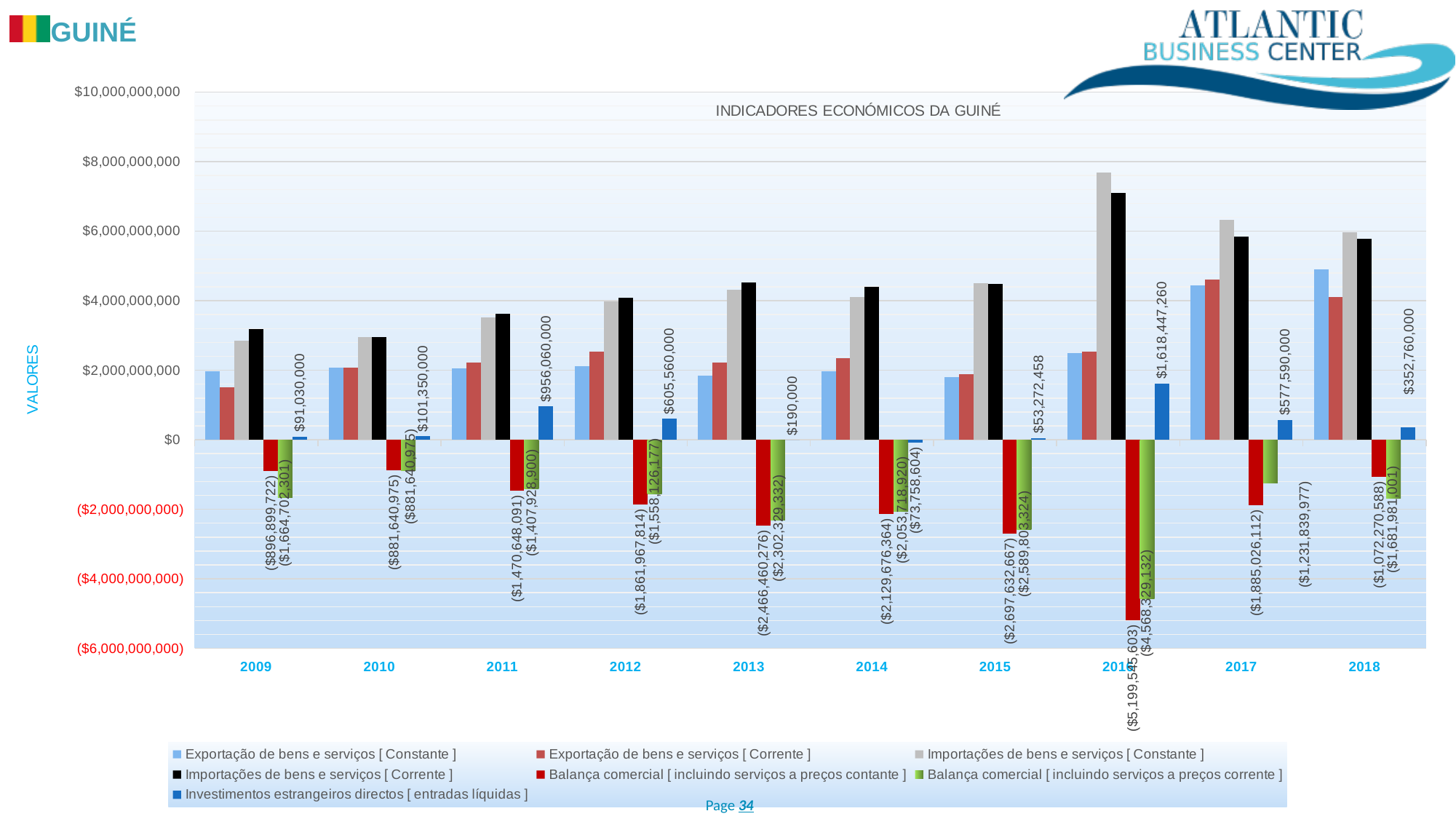
In which year is Investimentos estrangeiros directos [ entradas líquidas ] highest? 2016 Is the value for Importações de bens e serviços [ Constante ] in 2016 greater or less than $6,000,000,000? greater What is the value of Balança comercial [ incluindo serviços a preços corrente ] in 2013? ($2,302,329,332) What kind of chart is shown on the slide? bar chart What is the value of Investimentos estrangeiros directos [ entradas líquidas ] in 2011? $956,060,000 How many series does the chart legend list? 7 What is the value of Investimentos estrangeiros directos [ entradas líquidas ] in 2016? $1,618,447,260 How many years are shown on the x axis of the chart? 10 What is the title of the chart? INDICADORES ECONÓMICOS DA GUINÉ In which year is Balança comercial [ incluindo serviços a preços contante ] lowest (most negative)? 2016 Which year has the larger value for Exportação de bens e serviços [ Constante ], 2009 or 2018? 2018 What is the value of Investimentos estrangeiros directos [ entradas líquidas ] in 2014? ($73,758,604)